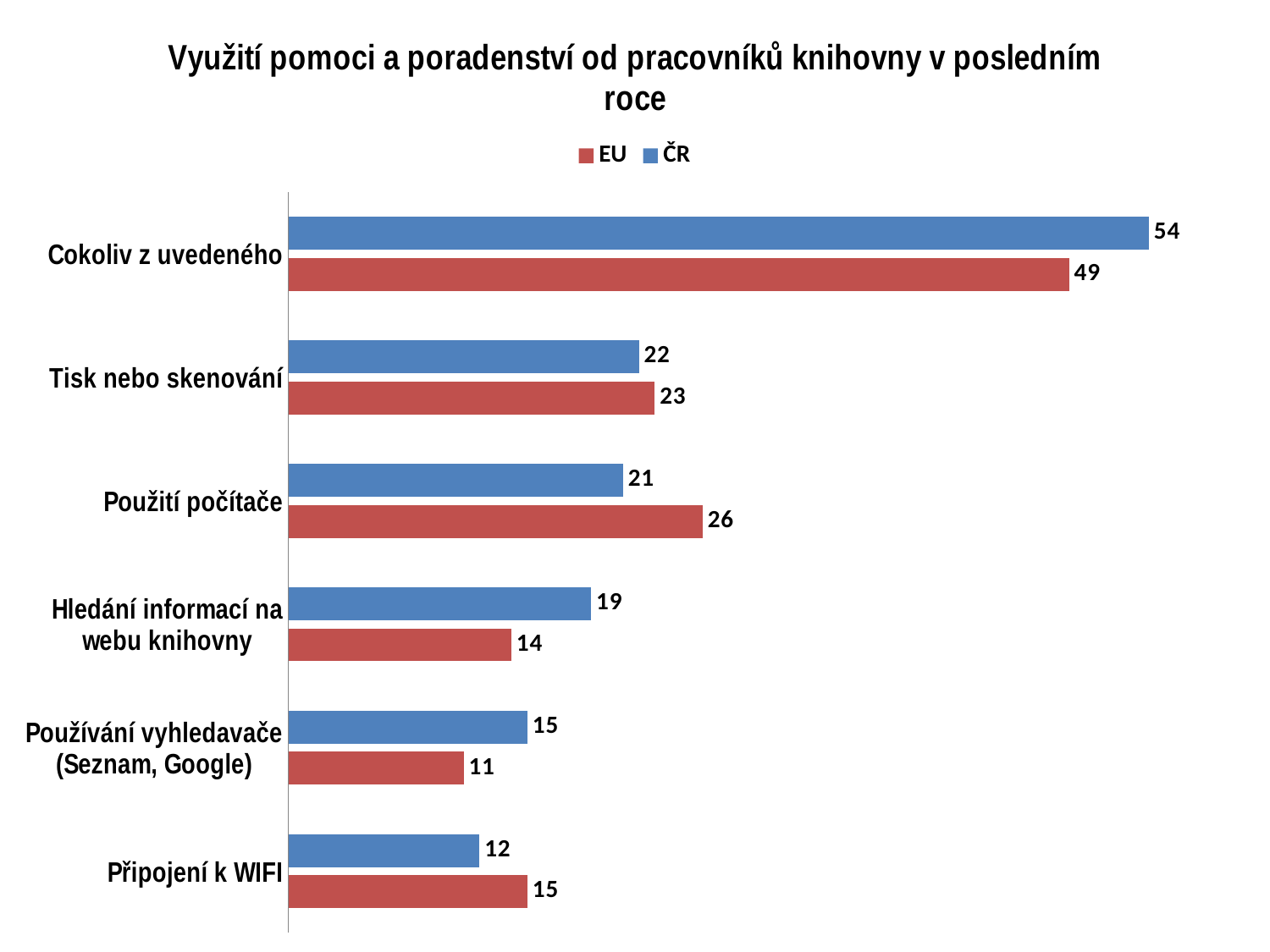
What is the difference between the EU and ČR values for Použití počítače? 5 Which category has the highest ČR value? Cokoliv z uvedeného What kind of chart is shown on the slide? Bar chart What is the difference between the ČR and EU values for Cokoliv z uvedeného? 5 How many categories are shown on the chart? 6 Which is larger for Hledání informací na webu knihovny, the ČR value or the EU value? ČR Which category has the lowest EU value? Používání vyhledavače (Seznam, Google) Which colour represents the EU series? Red What is the EU value for Použití počítače? 26 What is the ČR value for Cokoliv z uvedeného? 54 How many series does the legend list? 2 What is the EU value for Připojení k WIFI? 15